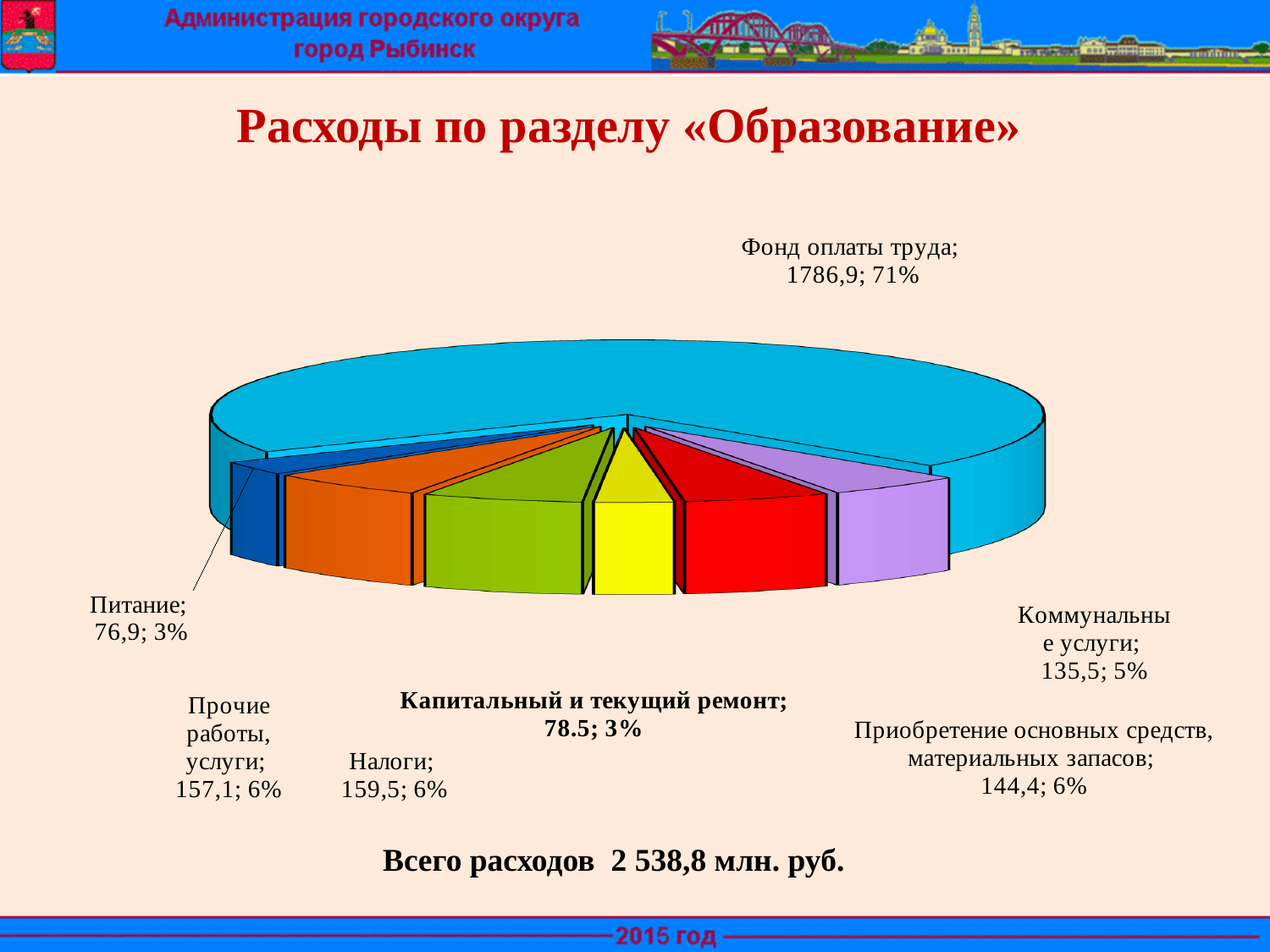
What share of the pie does Фонд оплаты труда represent? 71% What is the title of the chart on the slide? Расходы по разделу «Образование» What is the value for Питание? 76,9 What share of the pie does Налоги represent? 6% What kind of chart is shown on the slide? Pie chart What is the difference between the values for Налоги and Коммунальные услуги? 24,0 Which category has the largest slice of the pie? Фонд оплаты труда What is the value for Фонд оплаты труда? 1786,9 What is the value for Коммунальные услуги? 135,5 How many slices does the pie chart have? 7 Which category has the smallest value? Питание Which is larger, Налоги or Прочие работы, услуги? Налоги